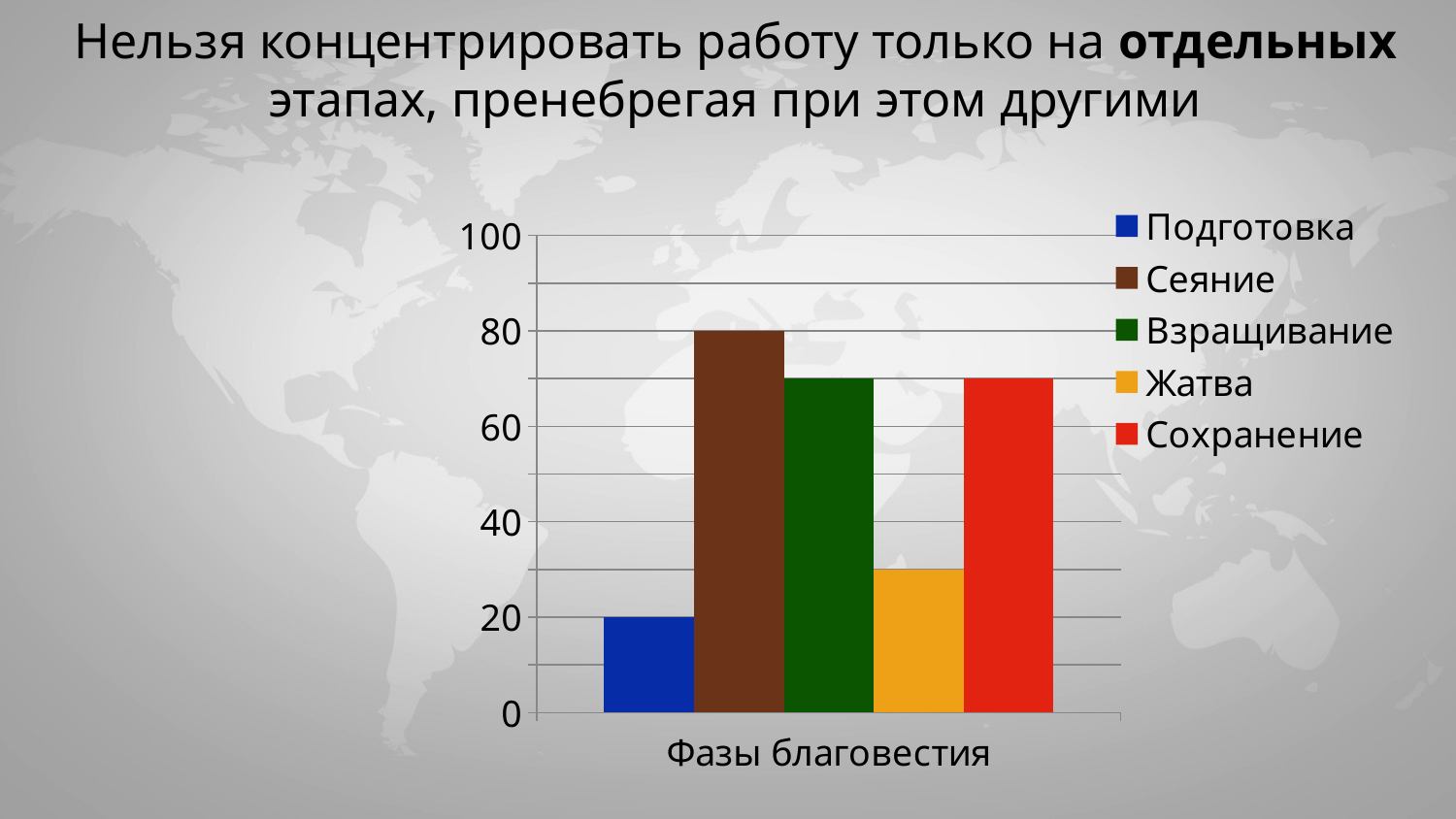
What is the value of the Сеяние bar? 80 How many series does the legend list? 5 Is the value for Сохранение greater or less than 80? less Which series has the lowest bar? Подготовка Which series has the highest bar? Сеяние Which is larger, the Сеяние bar or the Жатва bar? Сеяние What is the category label shown on the x axis? Фазы благовестия What is the value of the Подготовка bar? 20 Is the value for Взращивание greater or less than 60? greater What kind of chart is shown on the slide? bar chart What is the difference between the Сеяние bar and the Подготовка bar? 60 Is the value for Жатва greater or less than 40? less